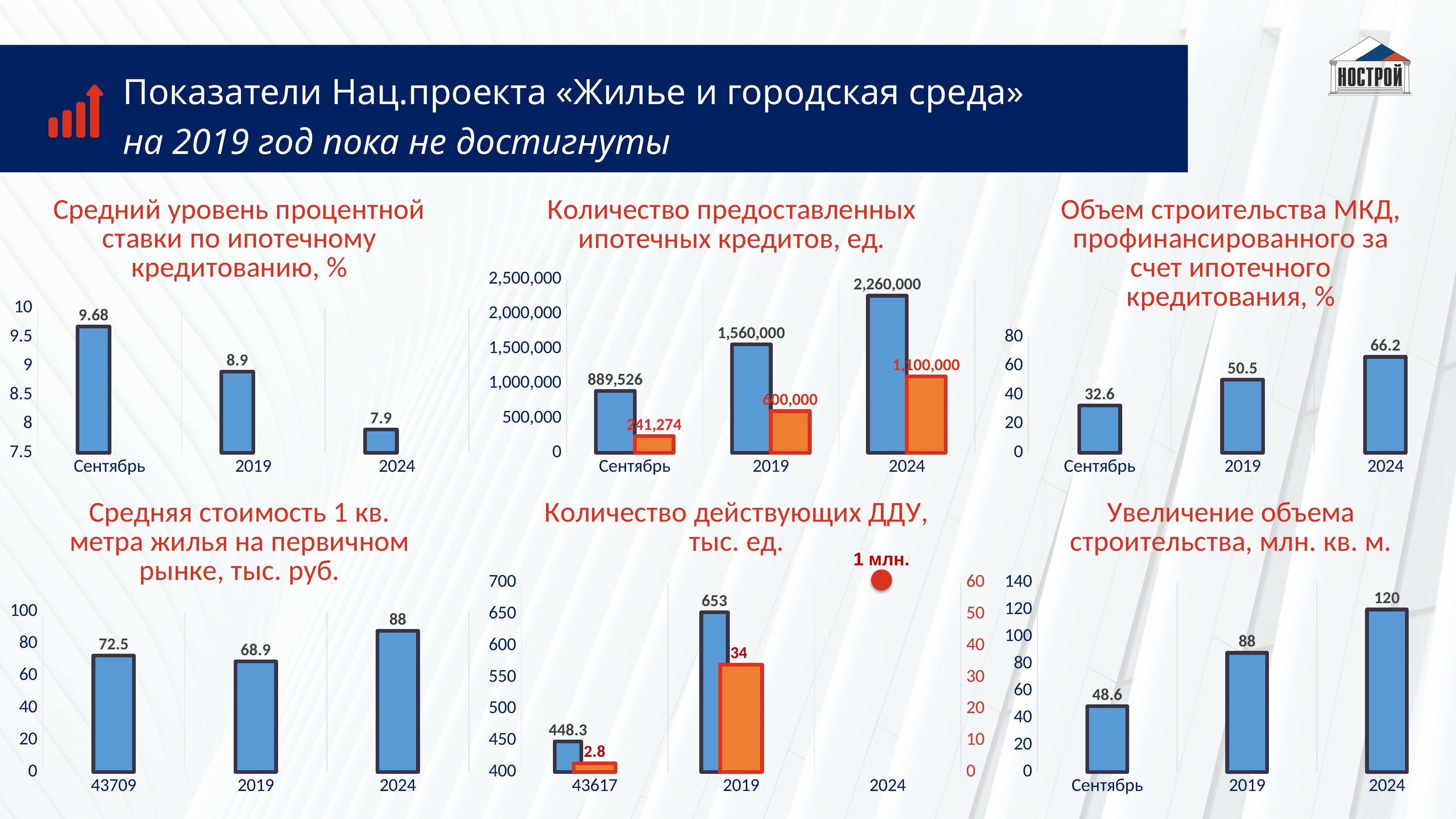
In the chart 'Средняя стоимость 1 кв. метра жилья на первичном рынке, тыс. руб.', what is the value for 2024? 88 In the chart 'Объем строительства МКД, профинансированного за счет ипотечного кредитования, %', what is the value for 2019? 50.5 In the chart 'Количество предоставленных ипотечных кредитов, ед.', what is the difference between the blue and orange bars for 2019? 960,000 In the chart 'Количество действующих ДДУ, тыс. ед.', what is the value of the blue bar for 2019? 653 In the chart 'Количество предоставленных ипотечных кредитов, ед.', what is the value of the blue bar for 2024? 2,260,000 In the chart 'Средний уровень процентной ставки по ипотечному кредитованию, %', what is the value for Сентябрь? 9.68 In the chart 'Средняя стоимость 1 кв. метра жилья на первичном рынке, тыс. руб.', which is larger, the value for 43709 or for 2019? 43709 In the chart 'Средний уровень процентной ставки по ипотечному кредитованию, %', do the values rise or fall from Сентябрь to 2024? fall In the chart 'Средний уровень процентной ставки по ипотечному кредитованию, %', which category has the lowest value? 2024 In the chart 'Количество предоставленных ипотечных кредитов, ед.', what is the value of the orange bar for Сентябрь? 241,274 In the chart 'Увеличение объема строительства, млн. кв. м.', what is the difference between the values for 2024 and Сентябрь? 71.4 In the chart 'Объем строительства МКД, профинансированного за счет ипотечного кредитования, %', how many bars are plotted? 3